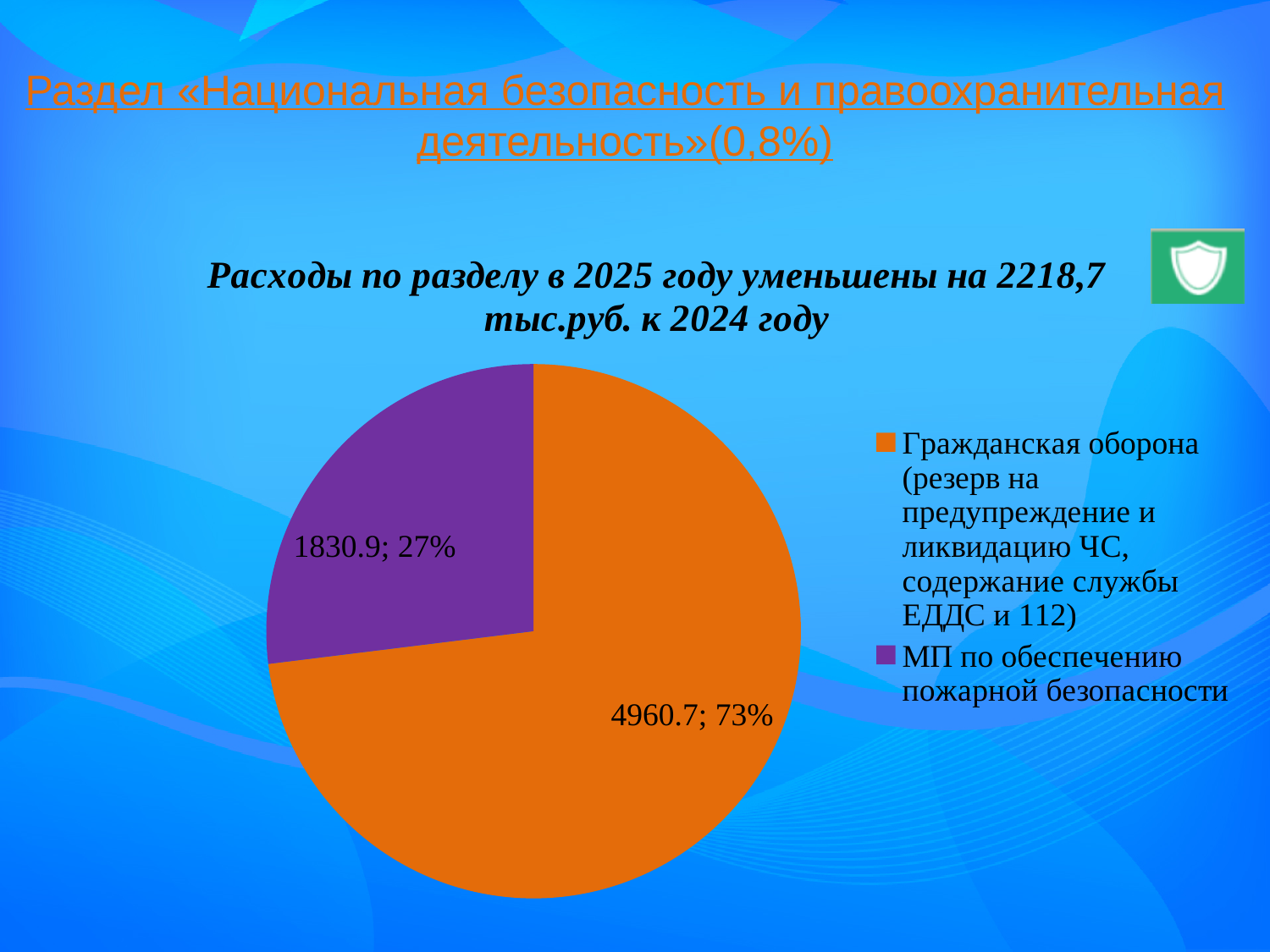
What share of the pie does "МП по обеспечению пожарной безопасности" take? 27% How many slices does the pie chart have? 2 Which slice of the pie chart is the smallest? МП по обеспечению пожарной безопасности What colour is the slice for "МП по обеспечению пожарной безопасности"? purple What kind of chart is shown on the slide? pie chart What share of the pie does "Гражданская оборона" take? 73% What is the value for "Гражданская оборона (резерв на предупреждение и ликвидацию ЧС, содержание службы ЕДДС и 112)" in the pie chart? 4960.7 What is the value for "МП по обеспечению пожарной безопасности" in the pie chart? 1830.9 What is the difference between the values for "Гражданская оборона" and "МП по обеспечению пожарной безопасности"? 3129.8 How many entries does the legend of the pie chart list? 2 What is the total of the two values shown in the pie chart? 6791.6 Which slice of the pie chart is the largest? Гражданская оборона (резерв на предупреждение и ликвидацию ЧС, содержание службы ЕДДС и 112)